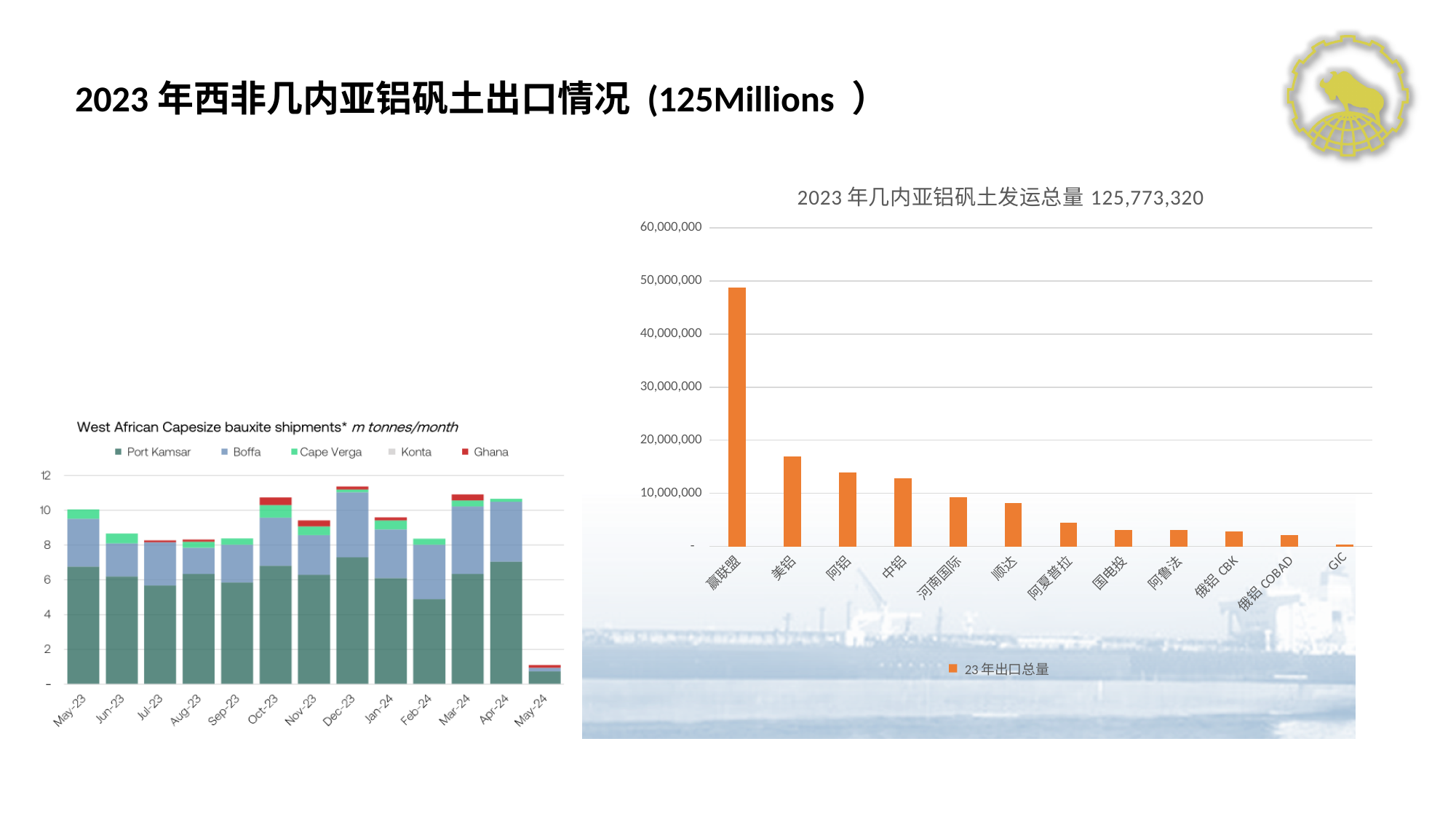
What kind of chart is the left chart (West African Capesize bauxite shipments)? stacked bar chart On the right chart (2023 年几内亚铝矾土发运总量), how many companies are shown on the x axis? 12 On the right chart (2023 年几内亚铝矾土发运总量), is the value for 美铝 greater or less than 10,000,000? greater On the left chart (West African Capesize bauxite shipments), is the total for Dec-23 greater or less than 10? greater On the right chart (2023 年几内亚铝矾土发运总量), which company has the highest export volume? 赢联盟 On the right chart (2023 年几内亚铝矾土发运总量), is the value for 赢联盟 greater or less than 40,000,000? greater On the right chart (2023 年几内亚铝矾土发运总量), which company has the lowest export volume? GIC On the right chart (2023 年几内亚铝矾土发运总量), what total shipment figure is given in the chart title? 125,773,320 On the left chart (West African Capesize bauxite shipments), which month has the lowest total shipments? May-24 On the right chart (2023 年几内亚铝矾土发运总量), which is larger, the value for 阿铝 or the value for 河南国际? 阿铝 On the left chart (West African Capesize bauxite shipments), how many series does the legend list? 5